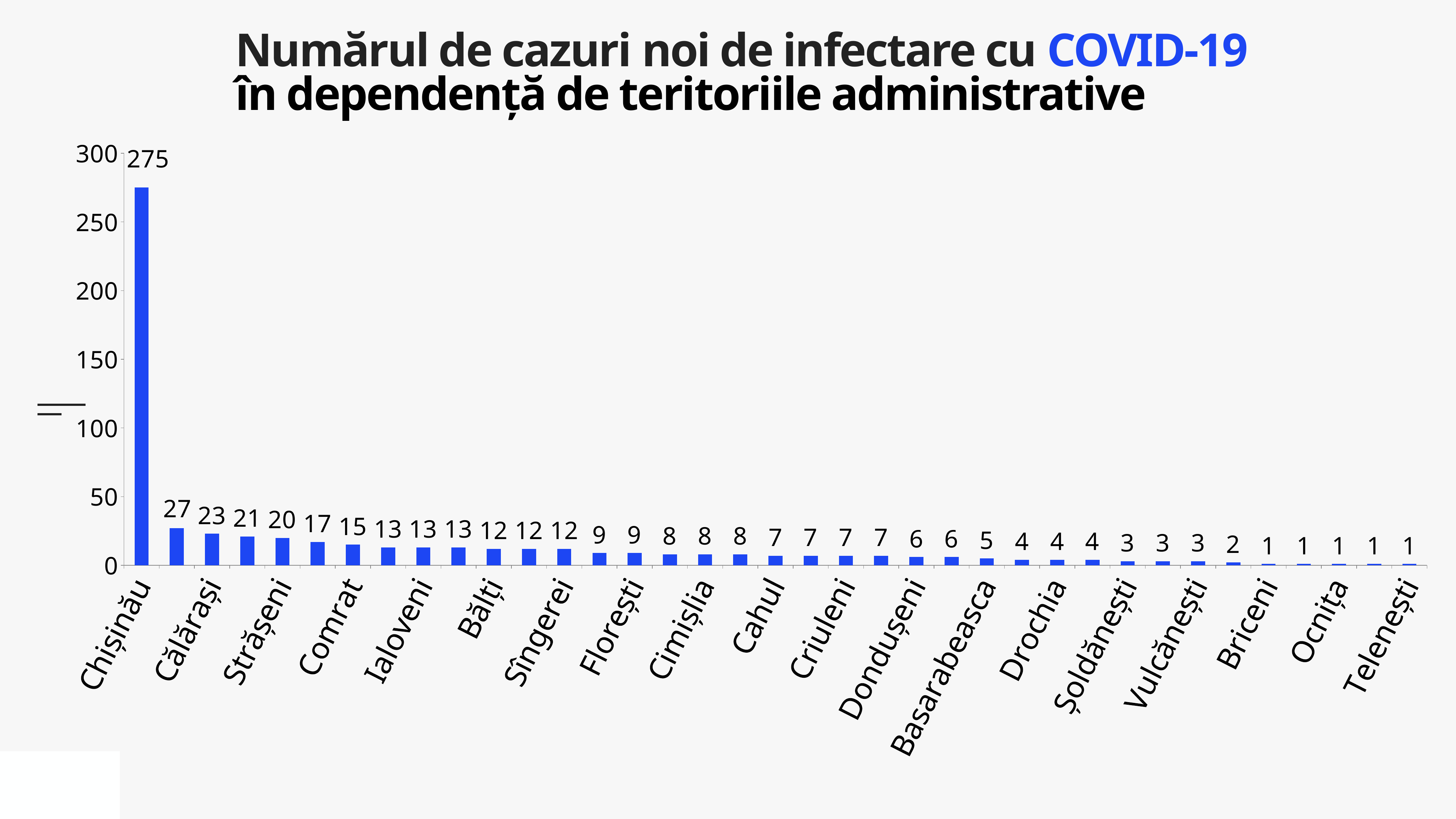
What is the lowest value shown on the chart? 1 What is the value shown for Călărași? 23 What is the value shown for Strășeni? 20 What is the value shown for Telenești? 1 Do the values rise or fall from left to right along the x axis? fall What is the difference between the values for Chișinău and Călărași? 252 What type of chart is shown on the slide? bar chart What colour are the bars in the chart? blue Which territory has the highest number of new cases? Chișinău What is the number of new COVID-19 cases for Chișinău? 275 Which has a larger value, Chișinău or Călărași? Chișinău Is the value for Chișinău greater or less than 250? greater